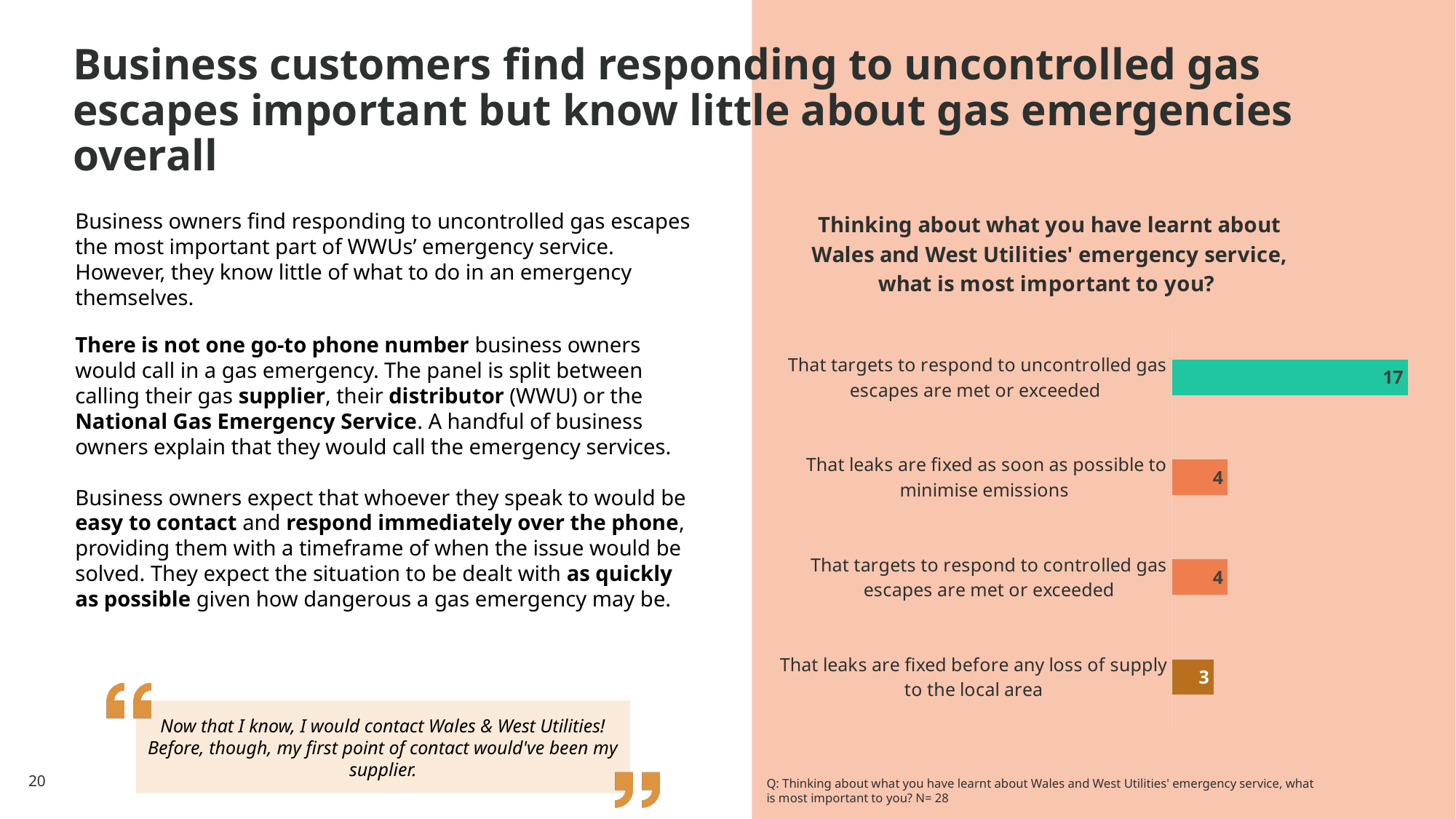
What is the value for 'That targets to respond to uncontrolled gas escapes are met or exceeded'? 17 What is the value for 'That leaks are fixed before any loss of supply to the local area'? 3 Which is larger: the value for 'That leaks are fixed as soon as possible to minimise emissions' or the value for 'That leaks are fixed before any loss of supply to the local area'? That leaks are fixed as soon as possible to minimise emissions What is the value for 'That leaks are fixed as soon as possible to minimise emissions'? 4 Which category has the lowest value? That leaks are fixed before any loss of supply to the local area What is the title of the chart? Thinking about what you have learnt about Wales and West Utilities' emergency service, what is most important to you? What kind of chart is shown on the slide? Bar chart What is the total of all four values shown in the chart? 28 Which category has the highest value? That targets to respond to uncontrolled gas escapes are met or exceeded What is the value for 'That targets to respond to controlled gas escapes are met or exceeded'? 4 What is the difference between the value for 'That targets to respond to uncontrolled gas escapes are met or exceeded' and the value for 'That leaks are fixed before any loss of supply to the local area'? 14 How many categories are shown in the chart? 4